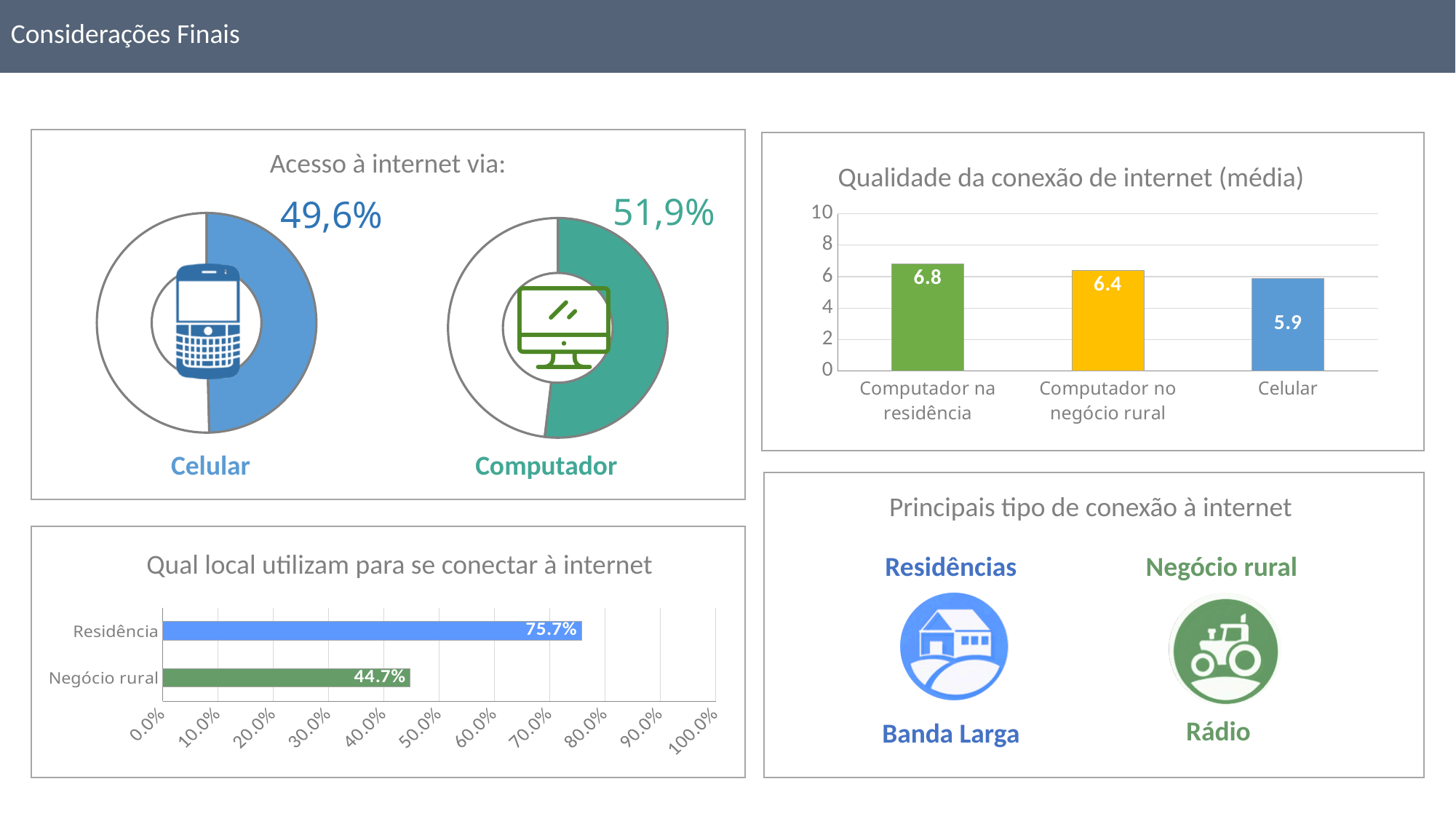
In the 'Qual local utilizam para se conectar à internet' chart, what is the value for Residência? 75.7% What kind of chart is 'Qual local utilizam para se conectar à internet'? Bar chart In the 'Qualidade da conexão de internet (média)' chart, what is the value for Celular? 5.9 In the 'Acesso à internet via:' chart, which is larger, Celular or Computador? Computador In the 'Qualidade da conexão de internet (média)' chart, which category has the lowest value? Celular In the 'Qualidade da conexão de internet (média)' chart, what is the value for Computador no negócio rural? 6.4 In the 'Qualidade da conexão de internet (média)' chart, what is the difference between Computador na residência and Celular? 0.9 In the 'Qualidade da conexão de internet (média)' chart, which category has the highest value? Computador na residência In the 'Acesso à internet via:' chart, what percentage is shown for Computador? 51,9% How many categories are shown in the 'Qualidade da conexão de internet (média)' chart? 3 In the 'Qual local utilizam para se conectar à internet' chart, what is the difference between Residência and Negócio rural? 31.0% In the 'Acesso à internet via:' chart, what percentage is shown for Celular? 49,6%